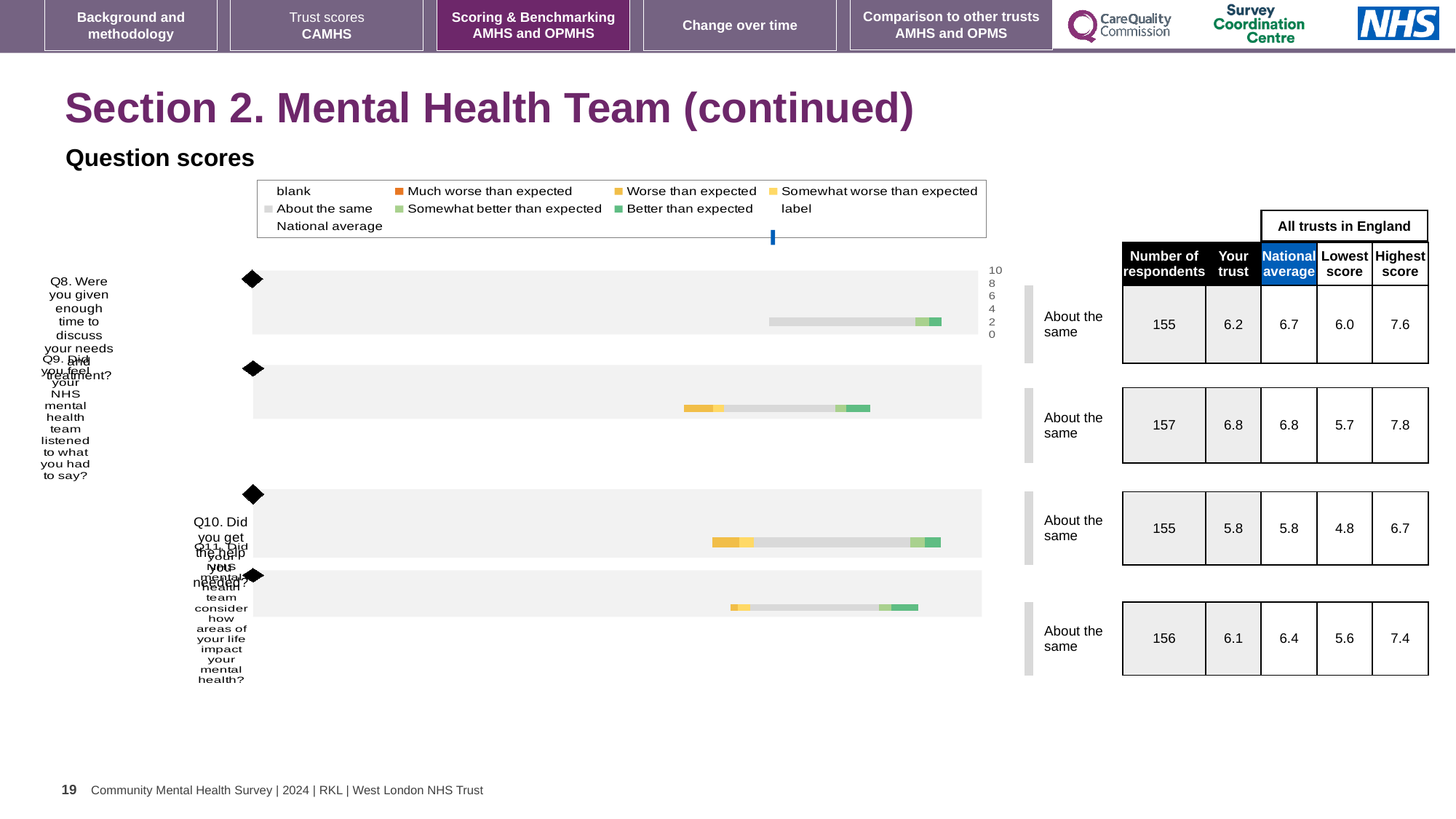
What benchmark category is shown next to the bar for Q10? About the same Which question has the lowest 'Lowest score' among all trusts in England? Q10 Which has the larger 'Your trust' score, Q9 or Q10? Q9 What is the 'Your trust' score for Q8 (Were you given enough time to discuss your needs and treatment?)? 6.2 By how much does the national average exceed the 'Your trust' score for Q11? 0.3 How many questions (bars) are plotted in the question scores chart? 4 Which question has the highest 'Your trust' score? Q9 What is the national average score for Q11 (Did your NHS mental health team consider how areas of your life impact your mental health?)? 6.4 What is the difference between the highest score and the lowest score for Q8? 1.6 How many entries does the legend of the question scores chart list? 9 What kind of chart is used to show the question scores for Q8 to Q11? bar chart How many respondents answered Q9 (Did you feel your NHS mental health team listened to what you had to say?)? 157